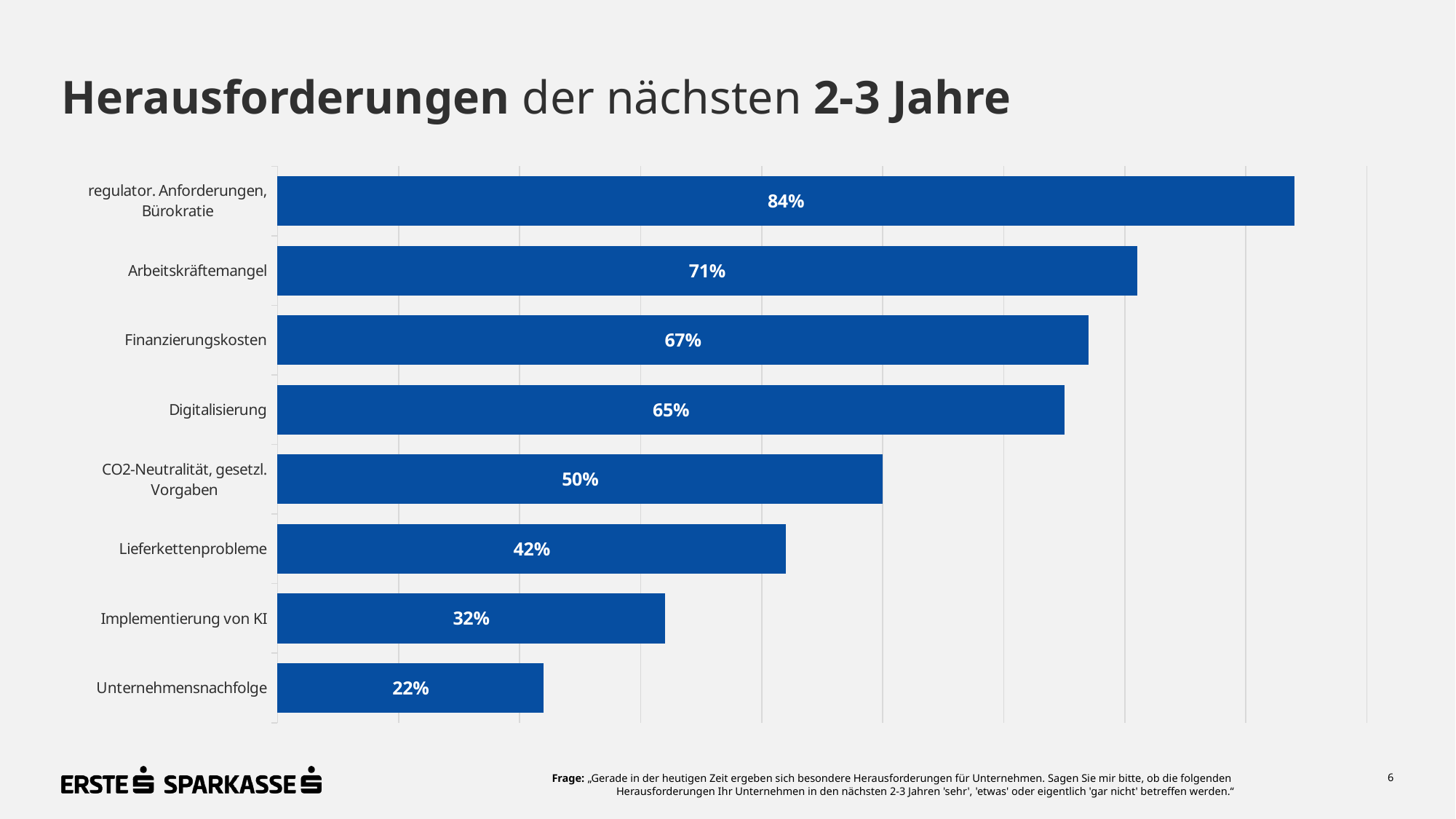
Which category has the lowest value? Unternehmensnachfolge How many categories are shown in the chart? 8 What kind of chart is shown on the slide? bar chart What is the value for Lieferkettenprobleme? 42% What is the value for Implementierung von KI? 32% Which category has the highest value? regulator. Anforderungen, Bürokratie Which is larger, the value for CO2-Neutralität, gesetzl. Vorgaben or the value for Lieferkettenprobleme? CO2-Neutralität, gesetzl. Vorgaben What is the difference between the values for Finanzierungskosten and Digitalisierung? 2% What is the difference between the values for regulator. Anforderungen, Bürokratie and Unternehmensnachfolge? 62% What is the title of the slide? Herausforderungen der nächsten 2-3 Jahre What is the value for Arbeitskräftemangel? 71% What is the value for Digitalisierung? 65%